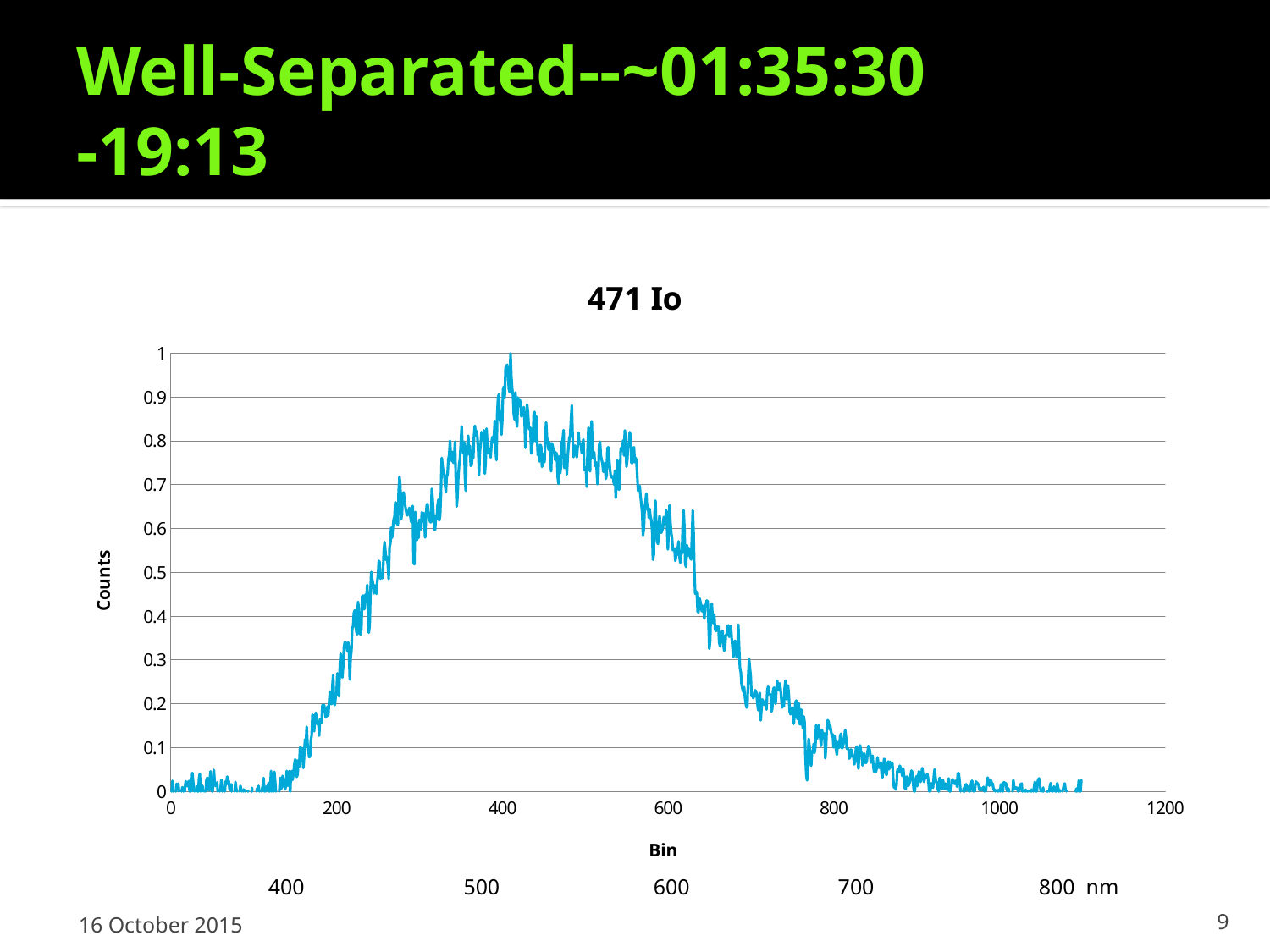
What is the title of the chart? 471 Io Is the value of the line at bin 200 greater or less than 0.5? less Is the value of the line at bin 1000 greater or less than 0.1? less Do the values rise or fall along the x axis between bin 200 and bin 400? rise What kind of chart is shown on the slide? line chart Which is larger, the value of the line at bin 400 or at bin 800? bin 400 Is the value of the line at bin 400 greater or less than 0.8? greater Do the values rise or fall along the x axis between bin 600 and bin 800? fall Near which x-axis tick does the line reach its highest value? 400 What is the label of the x axis of the chart? Bin